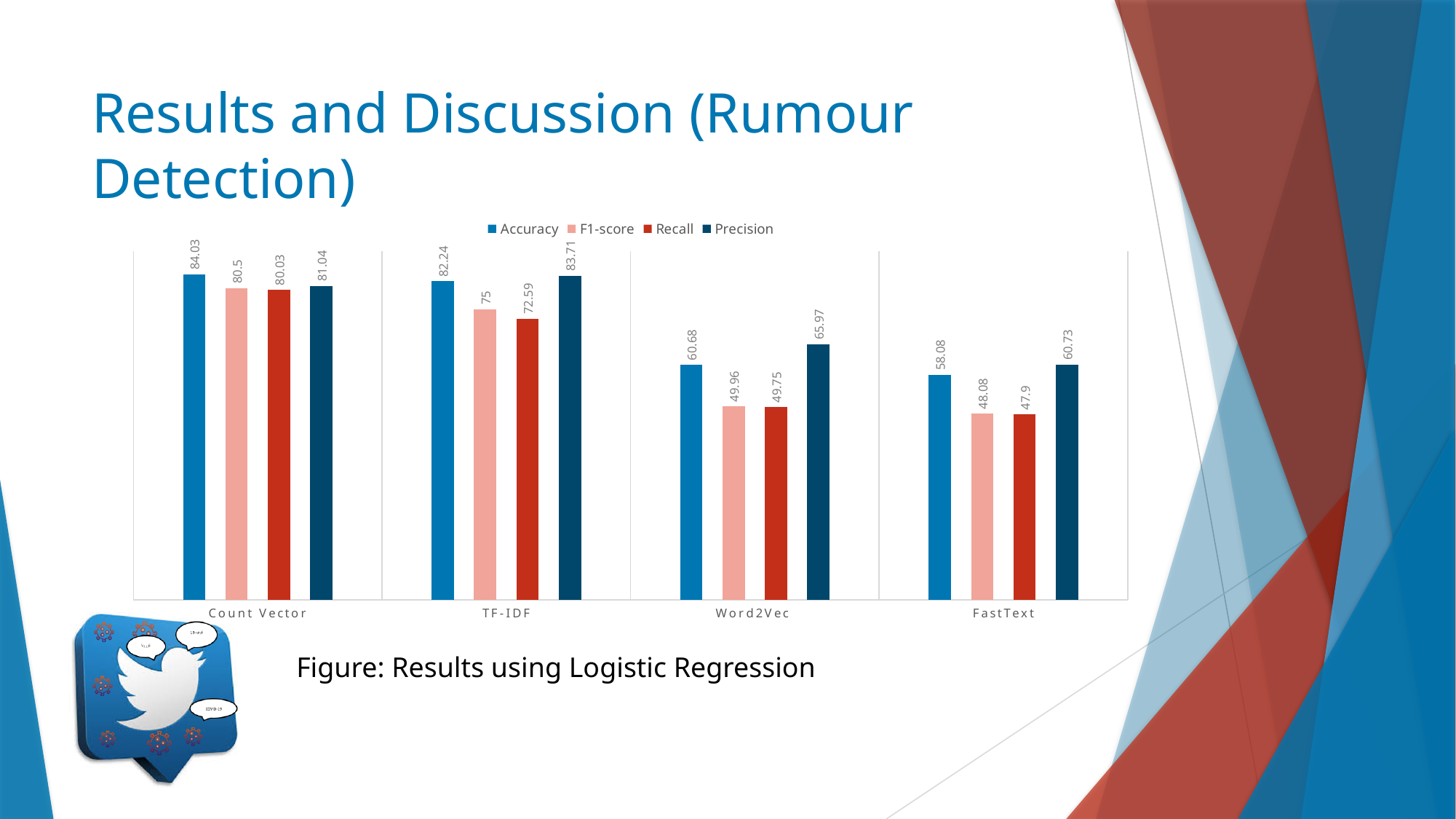
What kind of chart is shown on the slide? Bar chart What is the F1-score for TF-IDF? 75 How many series does the legend list? 4 Which is larger for Word2Vec, Accuracy or Precision? Precision What is the Recall value for FastText? 47.9 What is the Accuracy value for Count Vector? 84.03 What is the difference between the Precision and Accuracy values for TF-IDF? 1.47 Which category has the highest Accuracy? Count Vector Which category has the lowest Precision? FastText What is the Precision value for Word2Vec? 65.97 How many categories are shown on the x axis? 4 What is the caption given below the chart? Figure: Results using Logistic Regression